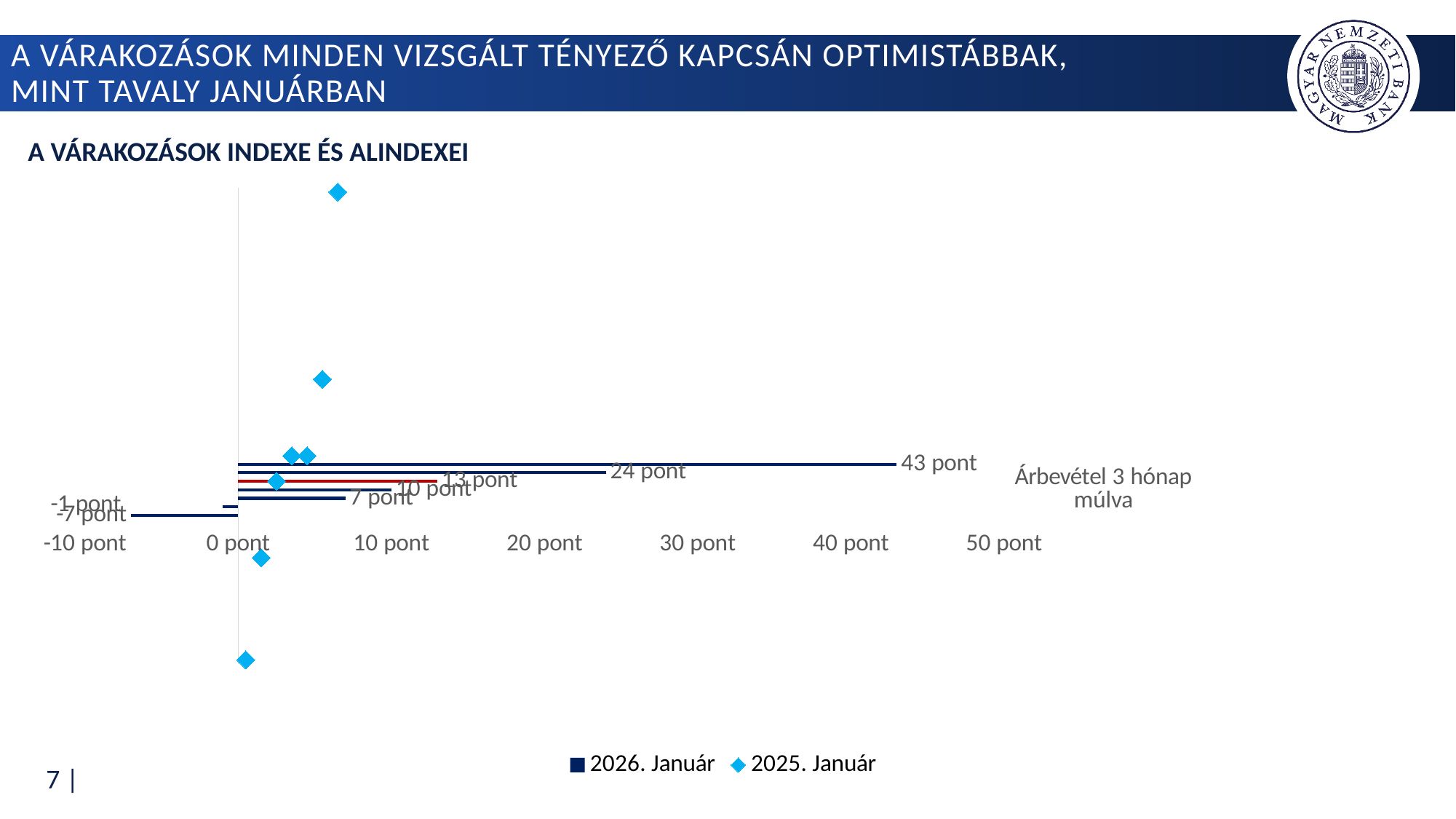
Which is larger among the labelled 2026. Január values: 43 pont or 24 pont? 43 pont What is the highest tick shown on the horizontal axis? 50 pont What are the two series named in the legend? 2026. Január and 2025. Január Is the largest labelled 2026. Január value greater or less than 40 pont? greater What is the lowest value labelled on a 2026. Január bar? -7 pont What is the lowest tick shown on the horizontal axis? -10 pont How many series does the legend list? 2 What is the difference between the two largest labelled 2026. Január values, 43 pont and 24 pont? 19 pont What is the highest value labelled on a 2026. Január bar? 43 pont What kind of chart is shown on the slide? bar chart